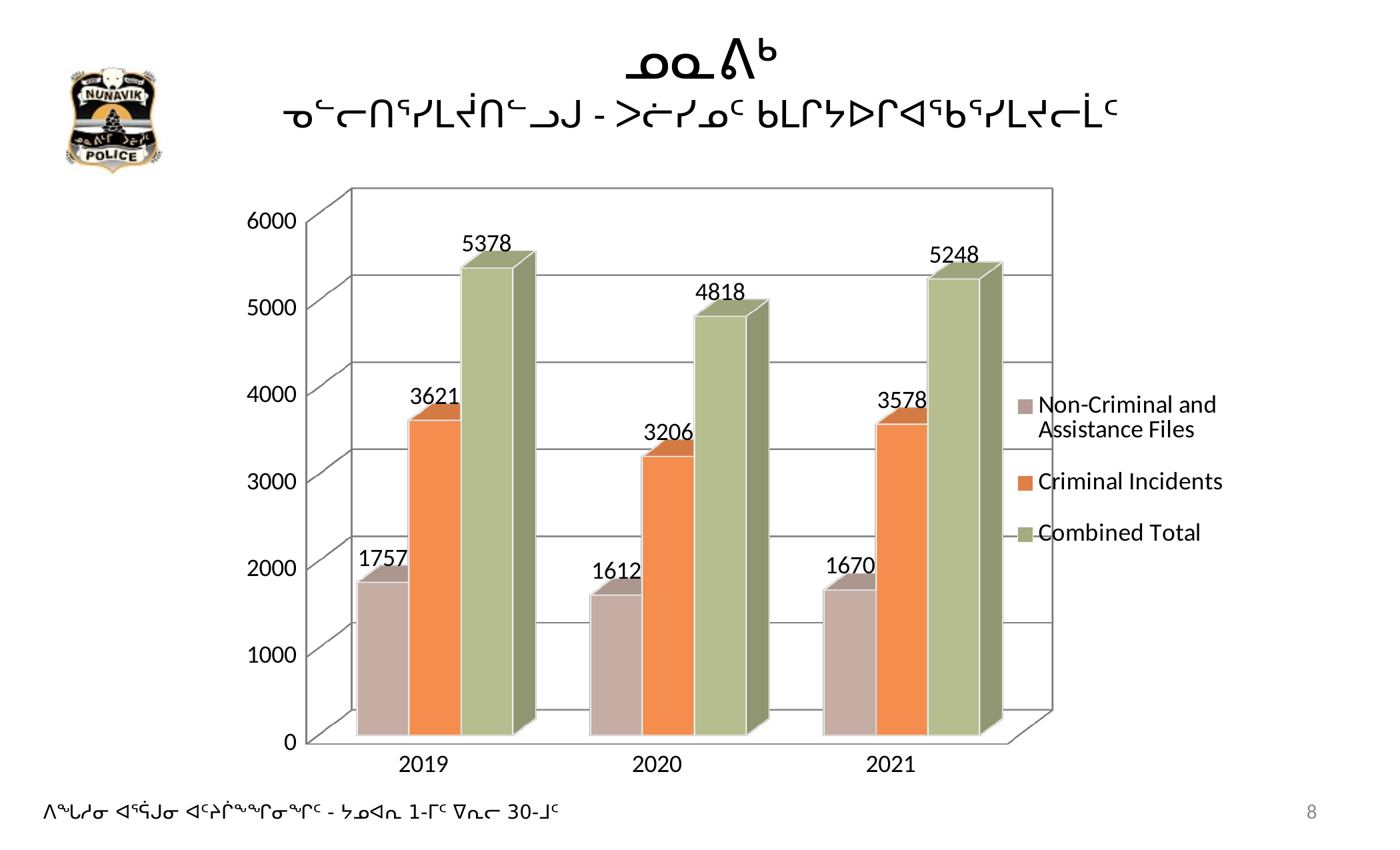
What is the difference between the Combined Total in 2019 and in 2020? 560 Which year has the highest Combined Total? 2019 What is the value of Criminal Incidents in 2019? 3621 What is the difference between Criminal Incidents in 2021 and Non-Criminal and Assistance Files in 2021? 1908 What is the Combined Total for 2021? 5248 Which is larger: Non-Criminal and Assistance Files in 2019 or in 2021? 2019 How many years are shown on the x axis? 3 What kind of chart is shown on the slide? Bar chart How many series does the legend list? 3 What is the value of Non-Criminal and Assistance Files in 2020? 1612 Which series is shown in orange in the legend? Criminal Incidents Which year has the lowest value for Criminal Incidents? 2020